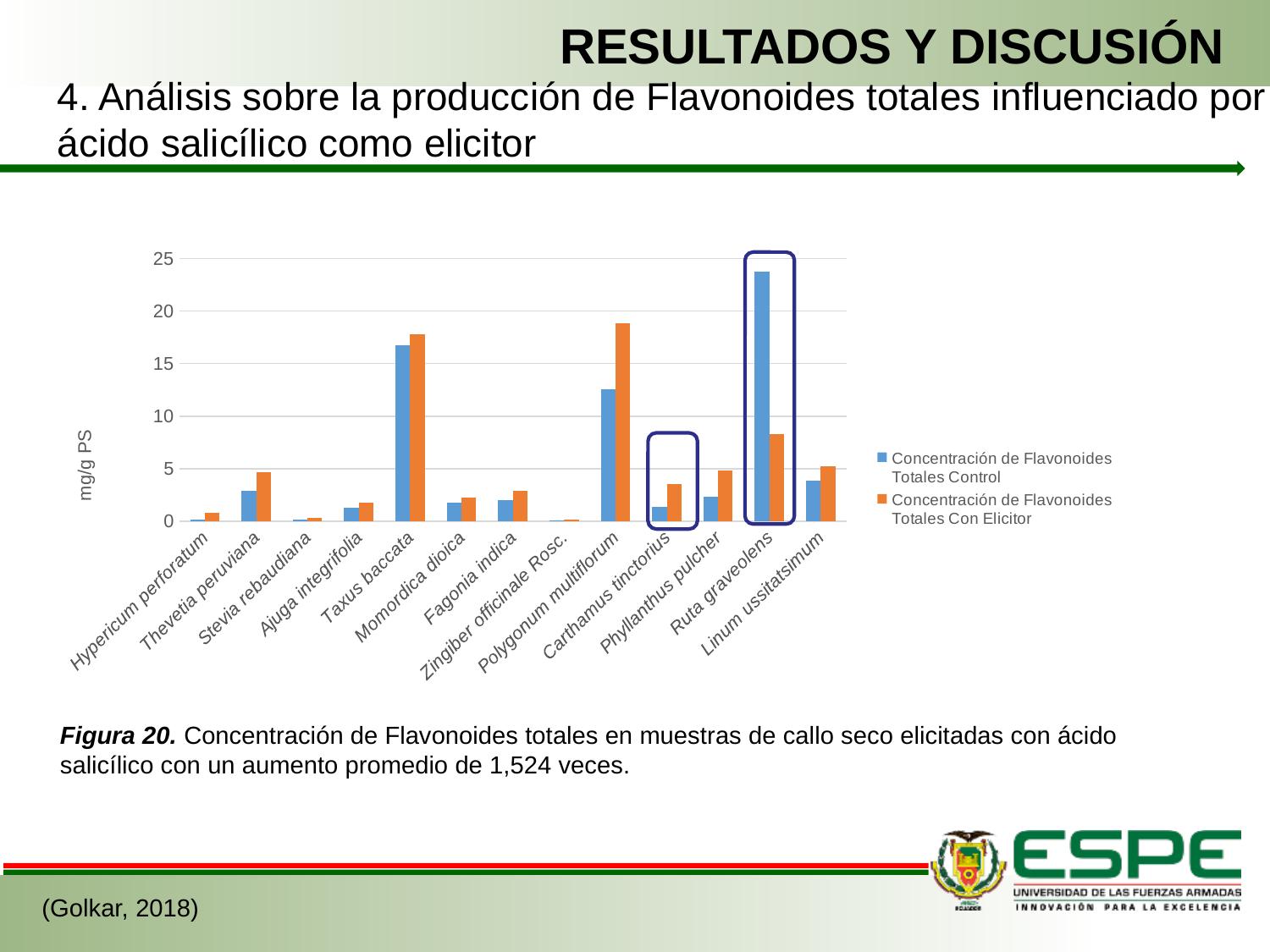
For Ruta graveolens, which is larger: the Control value or the Con Elicitor value? Control Is the Concentración de Flavonoides Totales Con Elicitor value for Taxus baccata greater or less than 15? greater Is the Concentración de Flavonoides Totales Con Elicitor value for Ruta graveolens greater or less than 10? less Is the Concentración de Flavonoides Totales Control value for Ruta graveolens greater or less than 20? greater For Polygonum multiflorum, which is larger: the Control value or the Con Elicitor value? Con Elicitor How many plant species (categories) are shown on the x axis of the chart? 13 What is the label on the y axis of the chart? mg/g PS Which species has the lowest values for both series in the chart? Zingiber officinale Rosc. How many series does the chart's legend list? 2 Which species has the highest value for Concentración de Flavonoides Totales Control? Ruta graveolens What kind of chart is shown on the slide? bar chart